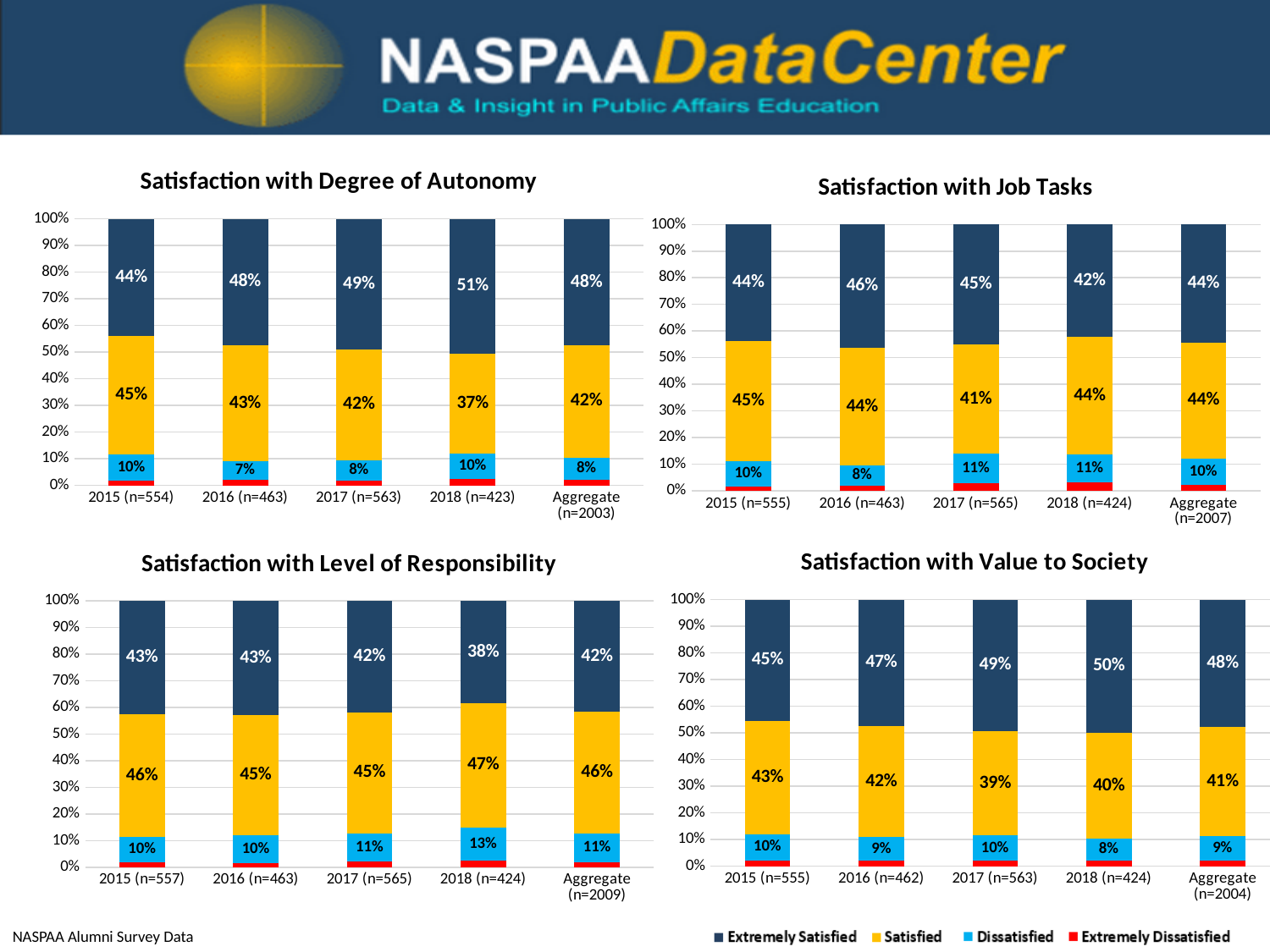
In the Satisfaction with Job Tasks chart, how many percentage points higher is the Extremely Satisfied share in 2016 (n=463) than in 2018 (n=424)? 4 percentage points How many bars are shown in the Satisfaction with Value to Society chart? 5 In the Satisfaction with Degree of Autonomy chart, which year has the highest Extremely Satisfied percentage? 2018 (n=423) What type of chart is the Satisfaction with Job Tasks chart? Stacked bar chart How many series does the legend at the bottom of the slide list? 4 In the Satisfaction with Job Tasks chart, what is the Satisfied percentage for 2017 (n=565)? 41% In the Satisfaction with Level of Responsibility chart, for 2018 (n=424), which is larger: the Satisfied share or the Extremely Satisfied share? Satisfied In the Satisfaction with Value to Society chart, does the Extremely Satisfied percentage rise or fall from 2015 to 2018? Rises In the Satisfaction with Degree of Autonomy chart, what percentage of 2018 (n=423) respondents were Extremely Satisfied? 51% In the Satisfaction with Degree of Autonomy chart, which category has the lowest Dissatisfied percentage? 2016 (n=463) In the Satisfaction with Value to Society chart, what is the Satisfied percentage for the Aggregate (n=2004) bar? 41% In the Satisfaction with Level of Responsibility chart, what is the Dissatisfied percentage for 2018 (n=424)? 13%